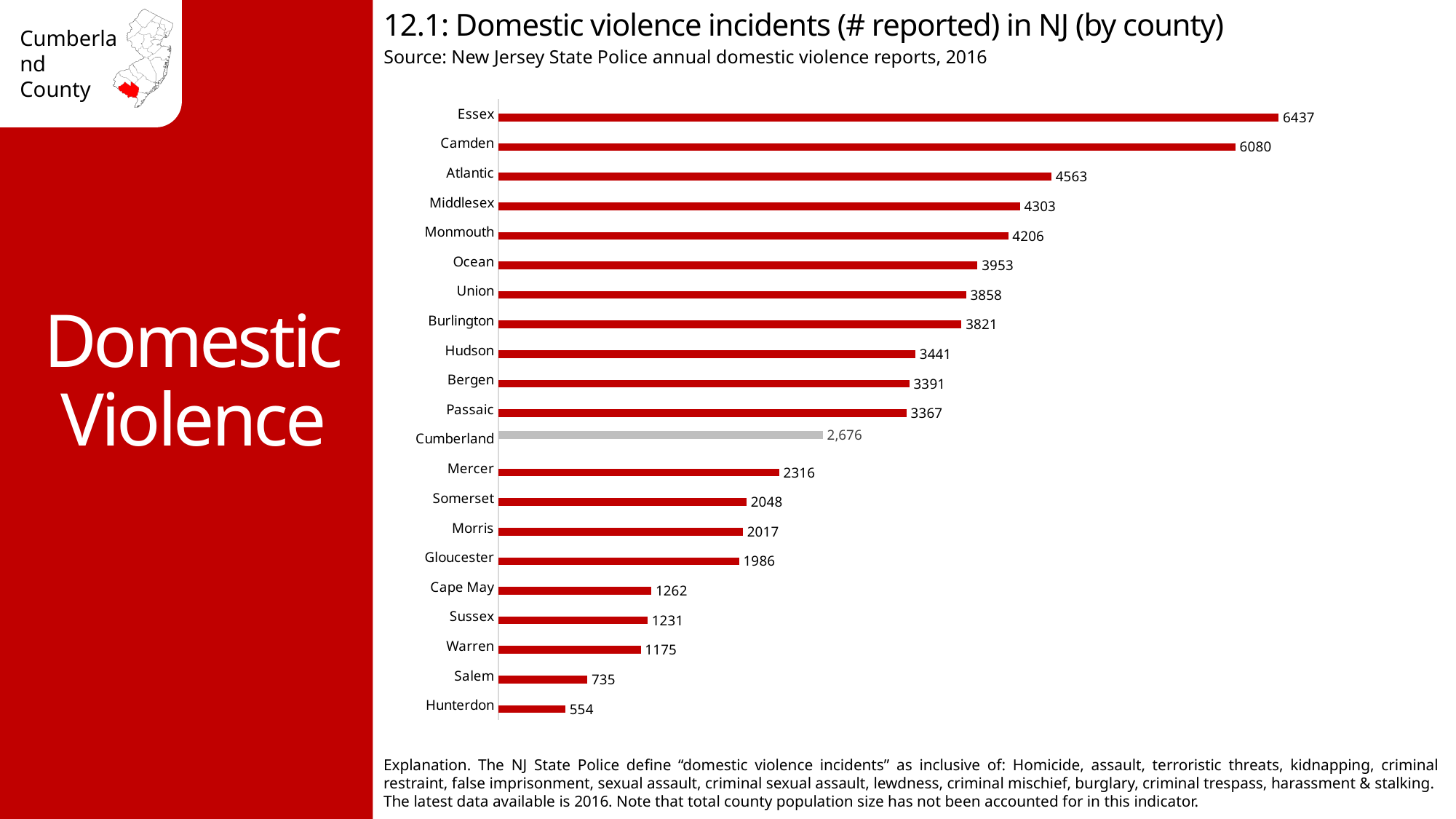
Which has a larger value, Atlantic or Middlesex? Atlantic What is the difference between the values for Essex and Camden? 357 How many domestic violence incidents were reported in Cumberland County? 2,676 Which has a larger value, Salem or Warren? Warren Which county has the highest number of reported domestic violence incidents? Essex What kind of chart is shown on the slide? Bar chart What is the value shown for Hunterdon? 554 What is the value shown for Cape May? 1262 How many counties are shown in the chart? 21 What is the value shown for Essex? 6437 Which county has the lowest number of reported domestic violence incidents? Hunterdon Which county's bar is coloured grey instead of red? Cumberland